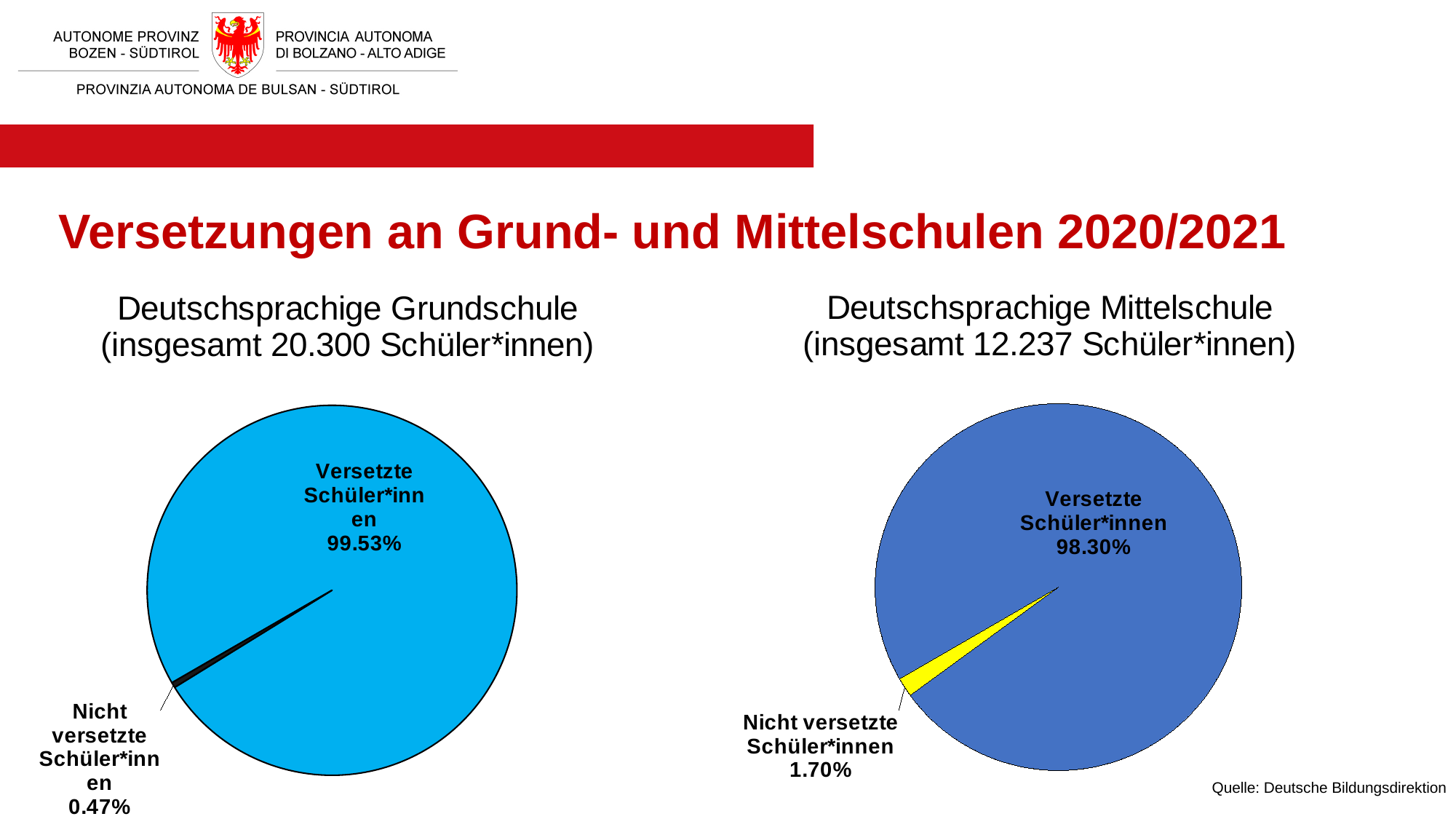
In the 'Deutschsprachige Mittelschule' pie chart, what share is labelled for 'Versetzte Schüler*innen'? 98.30% In the 'Deutschsprachige Mittelschule' pie chart, what share is labelled for 'Nicht versetzte Schüler*innen'? 1.70% What kind of chart is used for 'Deutschsprachige Grundschule'? Pie chart How many pie charts are shown on the slide? 2 In the 'Deutschsprachige Grundschule' pie chart, what share is labelled for 'Versetzte Schüler*innen'? 99.53% What colour is the 'Nicht versetzte Schüler*innen' slice in the 'Deutschsprachige Mittelschule' pie chart? Yellow In the 'Deutschsprachige Grundschule' pie chart, which slice is the largest? Versetzte Schüler*innen Which is larger: the share of 'Nicht versetzte Schüler*innen' in the 'Deutschsprachige Grundschule' chart or in the 'Deutschsprachige Mittelschule' chart? Deutschsprachige Mittelschule What is the difference between the 'Versetzte Schüler*innen' share in the 'Deutschsprachige Grundschule' chart and in the 'Deutschsprachige Mittelschule' chart? 1.23% In the 'Deutschsprachige Grundschule' pie chart, what share is labelled for 'Nicht versetzte Schüler*innen'? 0.47% In the 'Deutschsprachige Mittelschule' pie chart, which slice is the smallest? Nicht versetzte Schüler*innen How many slices does the 'Deutschsprachige Mittelschule' pie chart have? 2